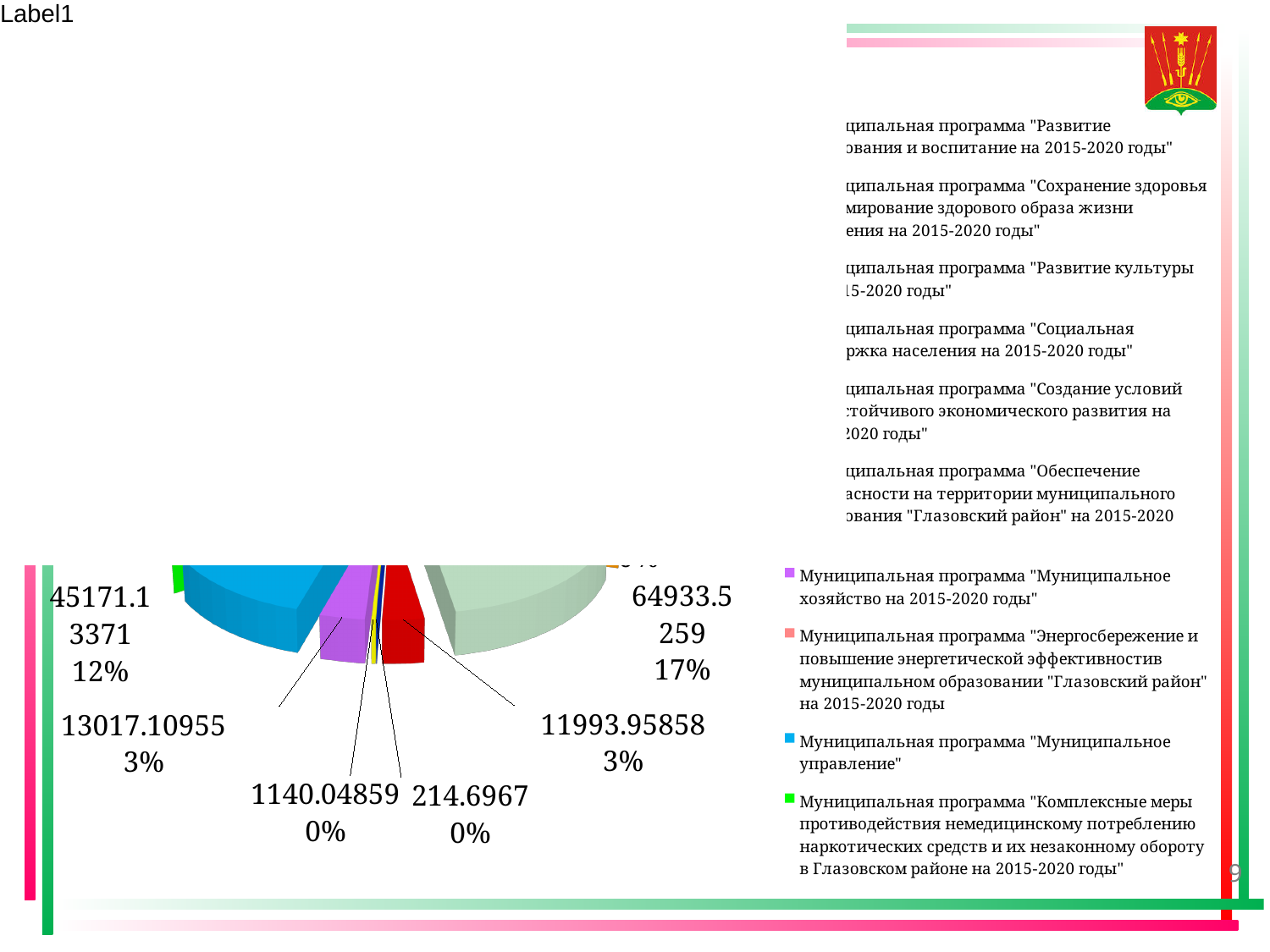
What kind of chart is shown on the slide? pie chart What is the difference between the value for Муниципальная программа "Муниципальное управление" and the value for Муниципальная программа "Муниципальное хозяйство на 2015-2020 годы"? 32154.02416 What share of the pie does the slice for Муниципальная программа "Муниципальное управление" represent? 12% What value is shown for the slice for Муниципальная программа "Муниципальное управление"? 45171.13371 What colour does the legend use for Муниципальная программа "Комплексные меры противодействия немедицинскому потреблению наркотических средств и их незаконному обороту в Глазовском районе на 2015-2020 годы"? green What is the largest percentage shown among the visible data labels on the pie chart? 17% Which value is labelled with the 17% share on the pie chart? 64933.5259 What share of the pie does the slice for Муниципальная программа "Муниципальное хозяйство на 2015-2020 годы" represent? 3% Which is larger: the slice for Муниципальная программа "Муниципальное управление" or the slice for Муниципальная программа "Муниципальное хозяйство на 2015-2020 годы"? Муниципальная программа "Муниципальное управление" What colour does the legend use for Муниципальная программа "Муниципальное управление"? blue What value is shown for the slice for Муниципальная программа "Муниципальное хозяйство на 2015-2020 годы"? 13017.10955